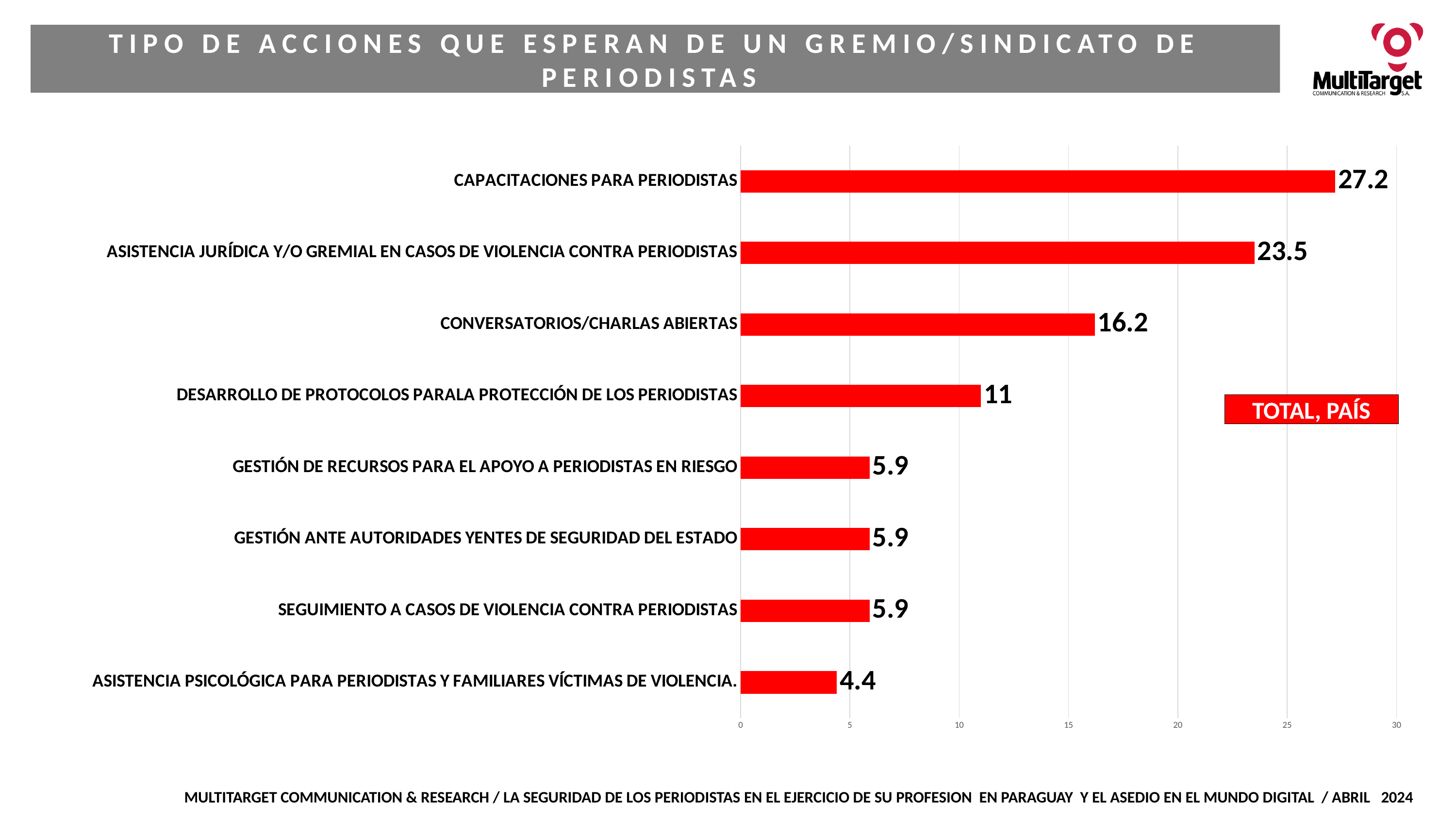
How many categories are shown in the chart? 8 Which category has the highest value? CAPACITACIONES PARA PERIODISTAS What label appears in the red box to the right of the chart? TOTAL, PAÍS Which is larger: the value for CONVERSATORIOS/CHARLAS ABIERTAS or the value for DESARROLLO DE PROTOCOLOS PARALA PROTECCIÓN DE LOS PERIODISTAS? CONVERSATORIOS/CHARLAS ABIERTAS What is the value for CONVERSATORIOS/CHARLAS ABIERTAS? 16.2 Is the value for ASISTENCIA JURÍDICA Y/O GREMIAL EN CASOS DE VIOLENCIA CONTRA PERIODISTAS greater or less than 20? greater What kind of chart is shown on the slide? bar chart What is the value for DESARROLLO DE PROTOCOLOS PARALA PROTECCIÓN DE LOS PERIODISTAS? 11 Which category has the lowest value? ASISTENCIA PSICOLÓGICA PARA PERIODISTAS Y FAMILIARES VÍCTIMAS DE VIOLENCIA. What is the difference between the values for CAPACITACIONES PARA PERIODISTAS and ASISTENCIA JURÍDICA Y/O GREMIAL EN CASOS DE VIOLENCIA CONTRA PERIODISTAS? 3.7 What is the value for CAPACITACIONES PARA PERIODISTAS? 27.2 What is the value for ASISTENCIA PSICOLÓGICA PARA PERIODISTAS Y FAMILIARES VÍCTIMAS DE VIOLENCIA.? 4.4